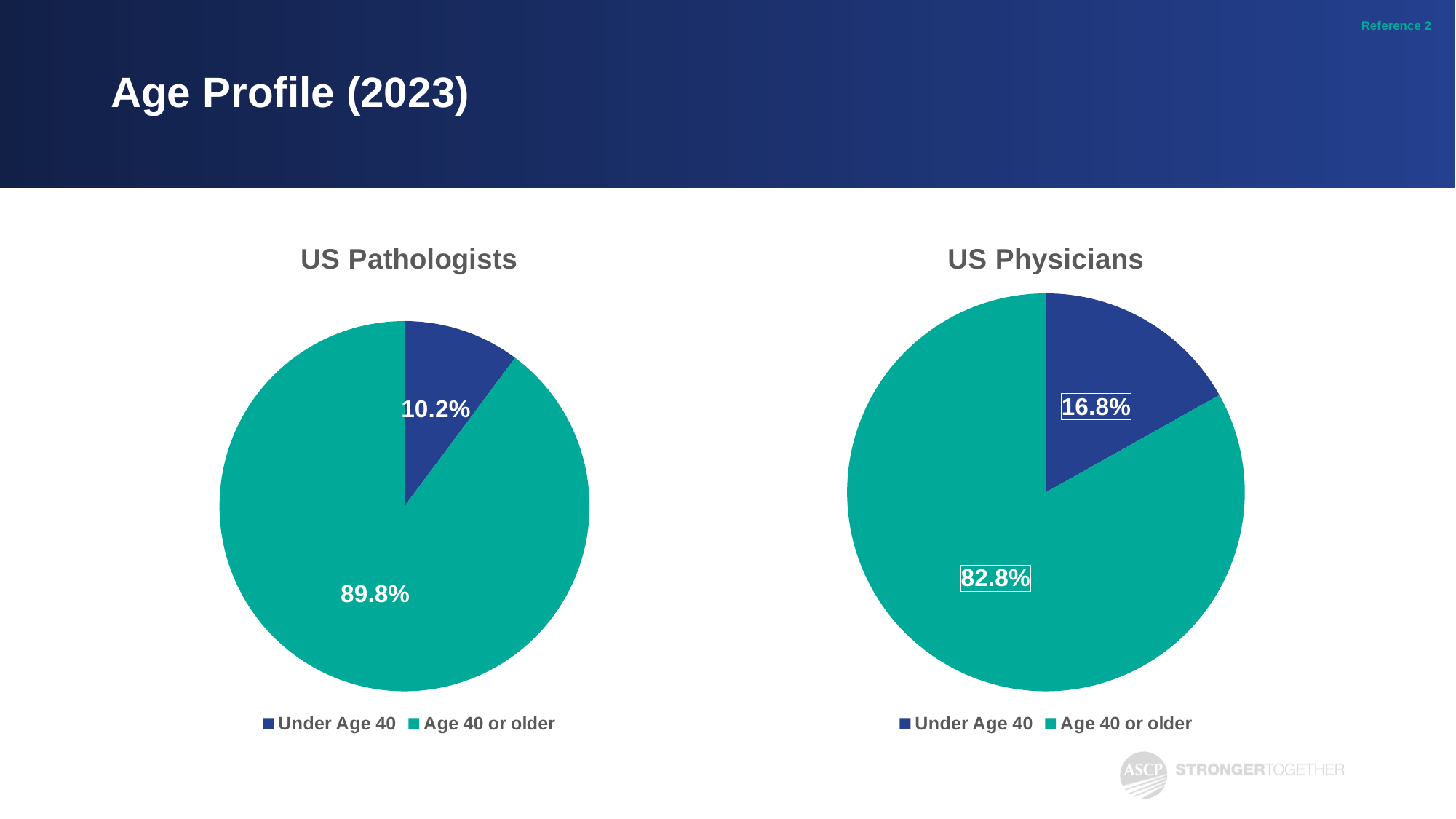
What is the difference between the Under Age 40 share in the US Physicians chart and the Under Age 40 share in the US Pathologists chart? 6.6 percentage points How many slices does the US Physicians pie chart have? 2 In the US Physicians chart, what colour is the Under Age 40 slice? Dark blue In the US Pathologists chart, what percentage of pathologists are age 40 or older? 89.8% What type of chart is the US Pathologists chart? Pie chart In the US Physicians chart, which slice is the smallest? Under Age 40 How many entries does the legend of the US Pathologists chart list? 2 In the US Physicians chart, what percentage of physicians are age 40 or older? 82.8% Which is larger: the Age 40 or older share in the US Pathologists chart or in the US Physicians chart? US Pathologists In the US Pathologists chart, which slice is the largest? Age 40 or older In the US Pathologists chart, what percentage of pathologists are under age 40? 10.2% In the US Physicians chart, what percentage of physicians are under age 40? 16.8%